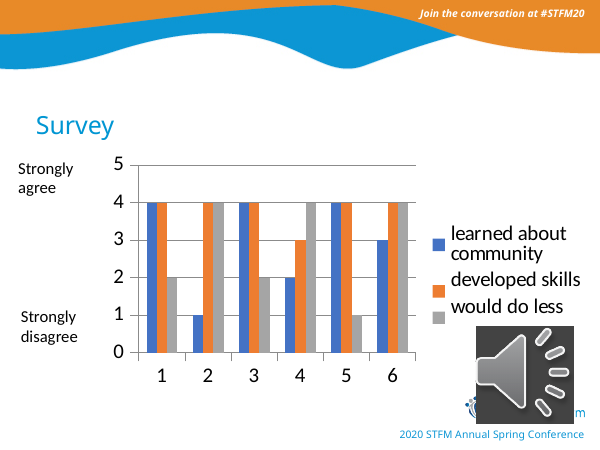
In category 1, what is the difference between 'learned about community' and 'would do less'? 2 What kind of chart is shown on the slide? bar chart Which category has the lowest value for 'would do less'? 5 Which category has the lowest value for 'learned about community'? 2 How many categories are shown on the x axis? 6 In category 4, which is larger: 'developed skills' or 'would do less'? would do less What is the value for 'would do less' in category 5? 1 What is the value for 'learned about community' in category 2? 1 How many series does the legend list? 3 What colour represents 'developed skills' in the legend? orange What is the title of the slide? Survey What is the value for 'developed skills' in category 4? 3